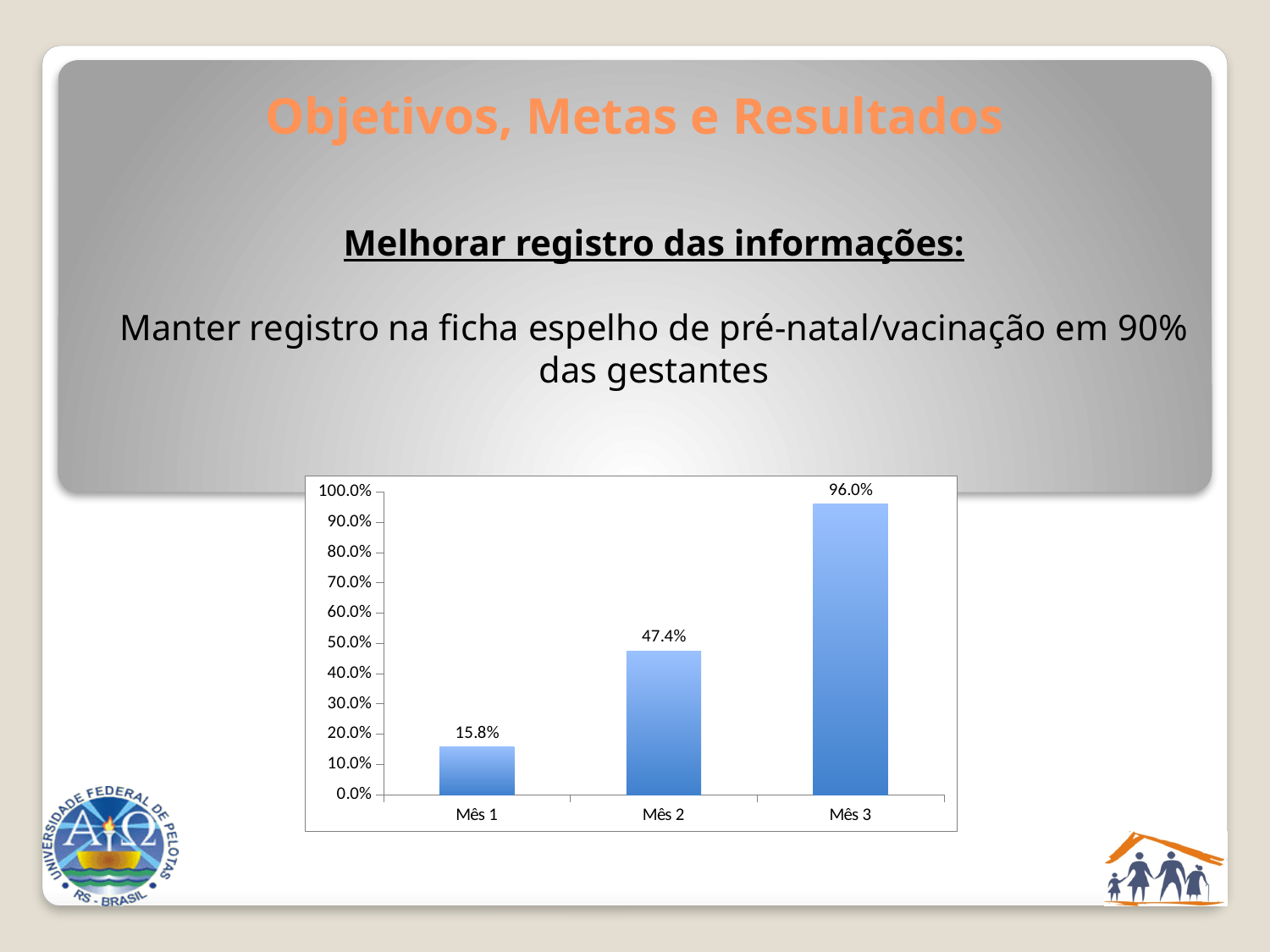
What is the value for Mês 1? 15.8% Which is larger, the value for Mês 2 or the value for Mês 3? Mês 3 What is the difference between the values for Mês 3 and Mês 1? 80.2% What is the difference between the values for Mês 2 and Mês 1? 31.6% How many categories are shown on the x axis? 3 Which month has the highest value? Mês 3 Which month has the lowest value? Mês 1 Is the value for Mês 2 greater or less than 50.0%? less What is the value for Mês 2? 47.4% What is the value for Mês 3? 96.0% Do the values rise or fall from Mês 1 to Mês 3? rise What kind of chart is shown on the slide? bar chart